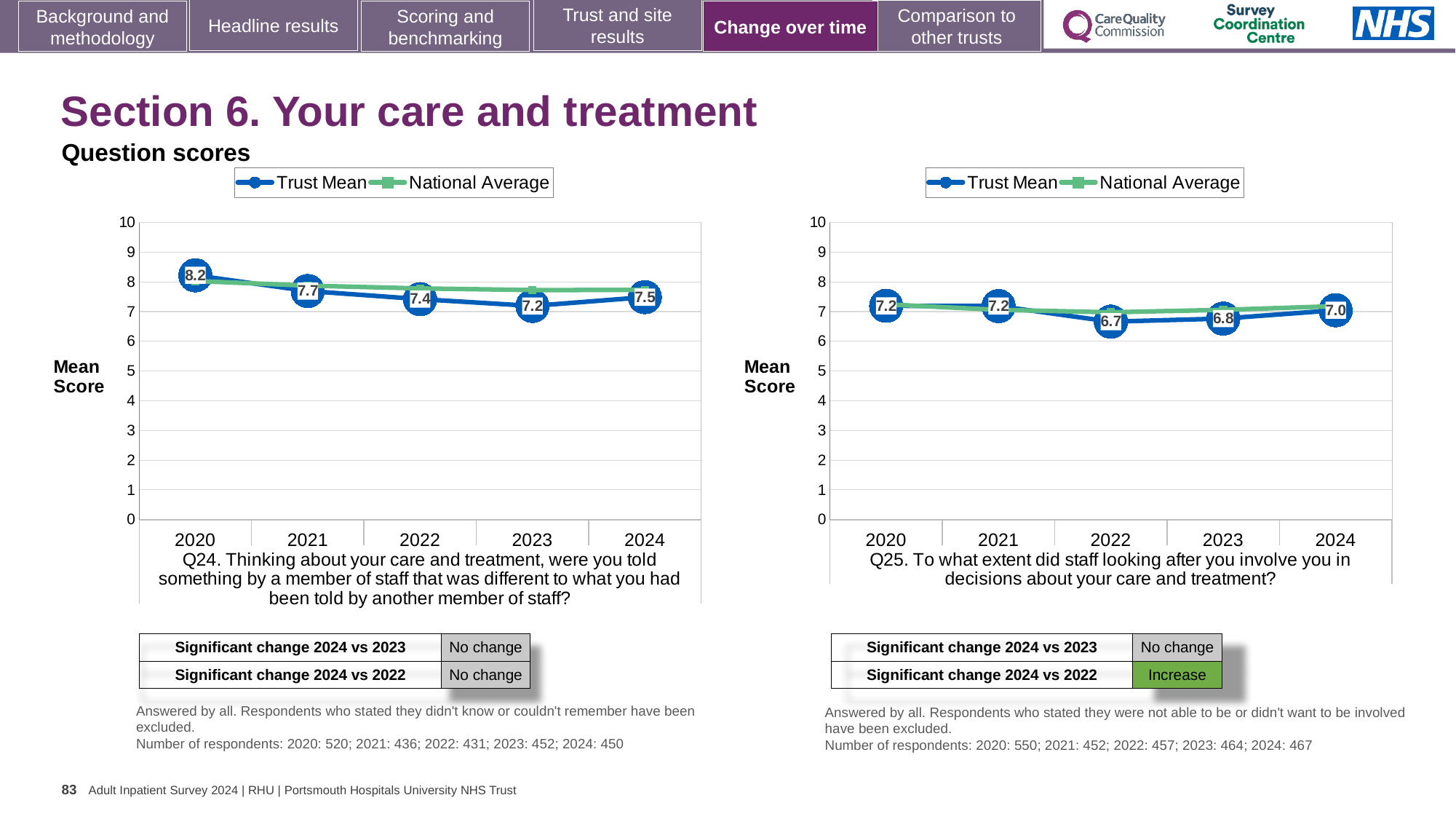
What type of chart is the Q25 chart on the right? line chart In the Q24 chart on the left, what is the difference between the Trust Mean scores for 2020 and 2024? 0.7 In the Q24 chart on the left, is the National Average for 2024 greater or less than 7? greater In the Q25 chart on the right, is the Trust Mean score for 2023 higher or lower than for 2024? lower How many series does the legend of the Q24 chart on the left list? 2 In the Q25 chart on the right, which year has the lowest Trust Mean score? 2022 In the Q25 chart on the right, what is the Trust Mean score for 2024? 7.0 How many years are shown on the x axis of the Q25 chart on the right? 5 In the Q24 chart on the left, what is the Trust Mean score for 2020? 8.2 In the Q24 chart on the left, which year has the highest Trust Mean score? 2020 In the Q24 chart on the left, what is the Trust Mean score for 2023? 7.2 In the Q25 chart on the right, what is the Trust Mean score for 2022? 6.7